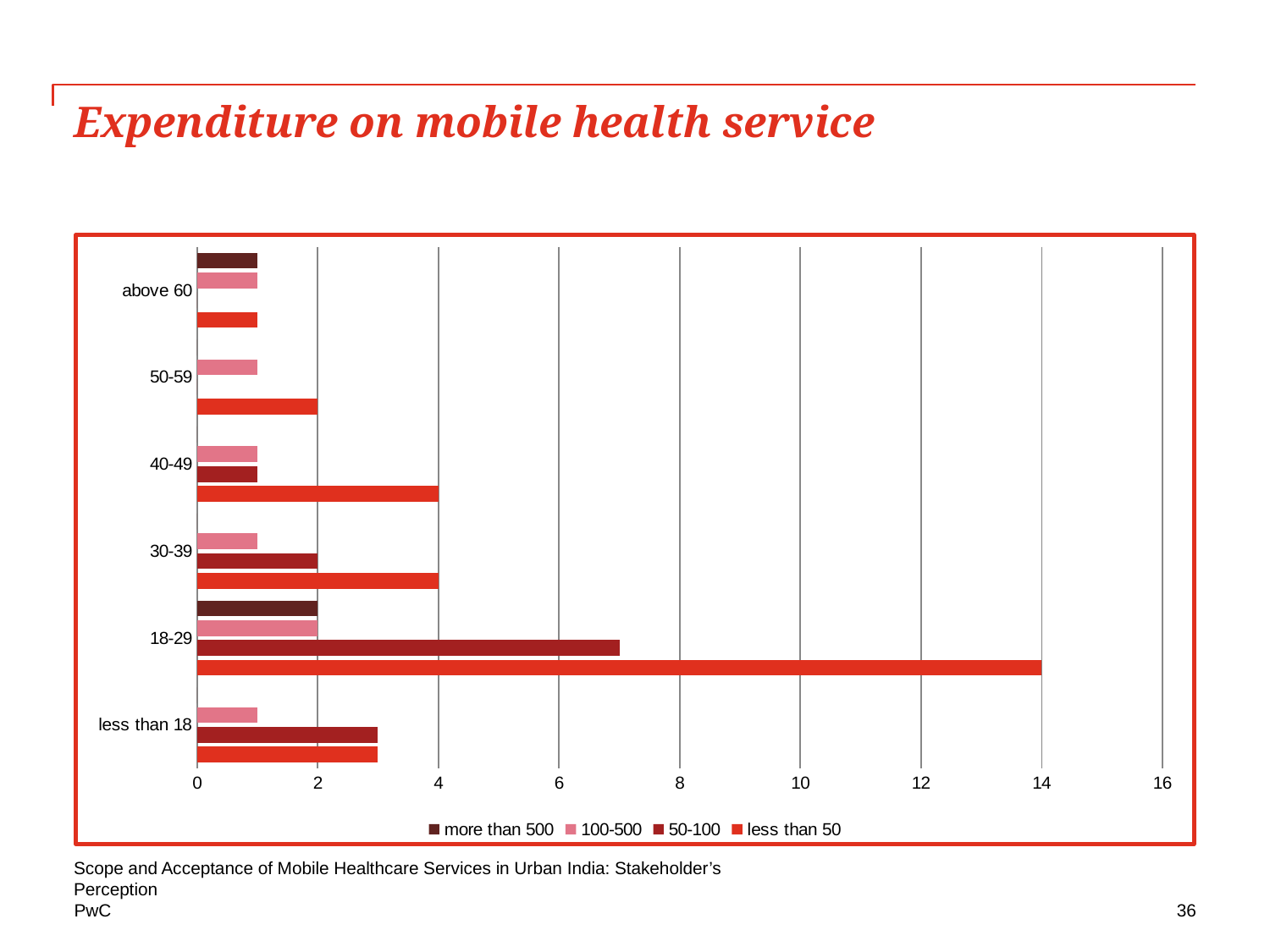
What is the value of the 'less than 50' series for the 18-29 age group? 14 Which age group has the highest value for the 'less than 50' series? 18-29 What is the value of the 'more than 500' series for the 18-29 age group? 2 What kind of chart is shown on the slide? bar chart What is the value of the 'less than 50' series for the 50-59 age group? 2 Is the value of the 'less than 50' series for the above 60 age group greater or less than 2? less What is the title of the slide? Expenditure on mobile health service How many age categories are shown on the chart? 6 How many series does the legend list? 4 What is the difference between the 'less than 50' values for the 18-29 and 40-49 age groups? 10 Is the value of the '50-100' series for the 18-29 age group greater or less than 6? greater What is the value of the 'less than 50' series for the 30-39 age group? 4